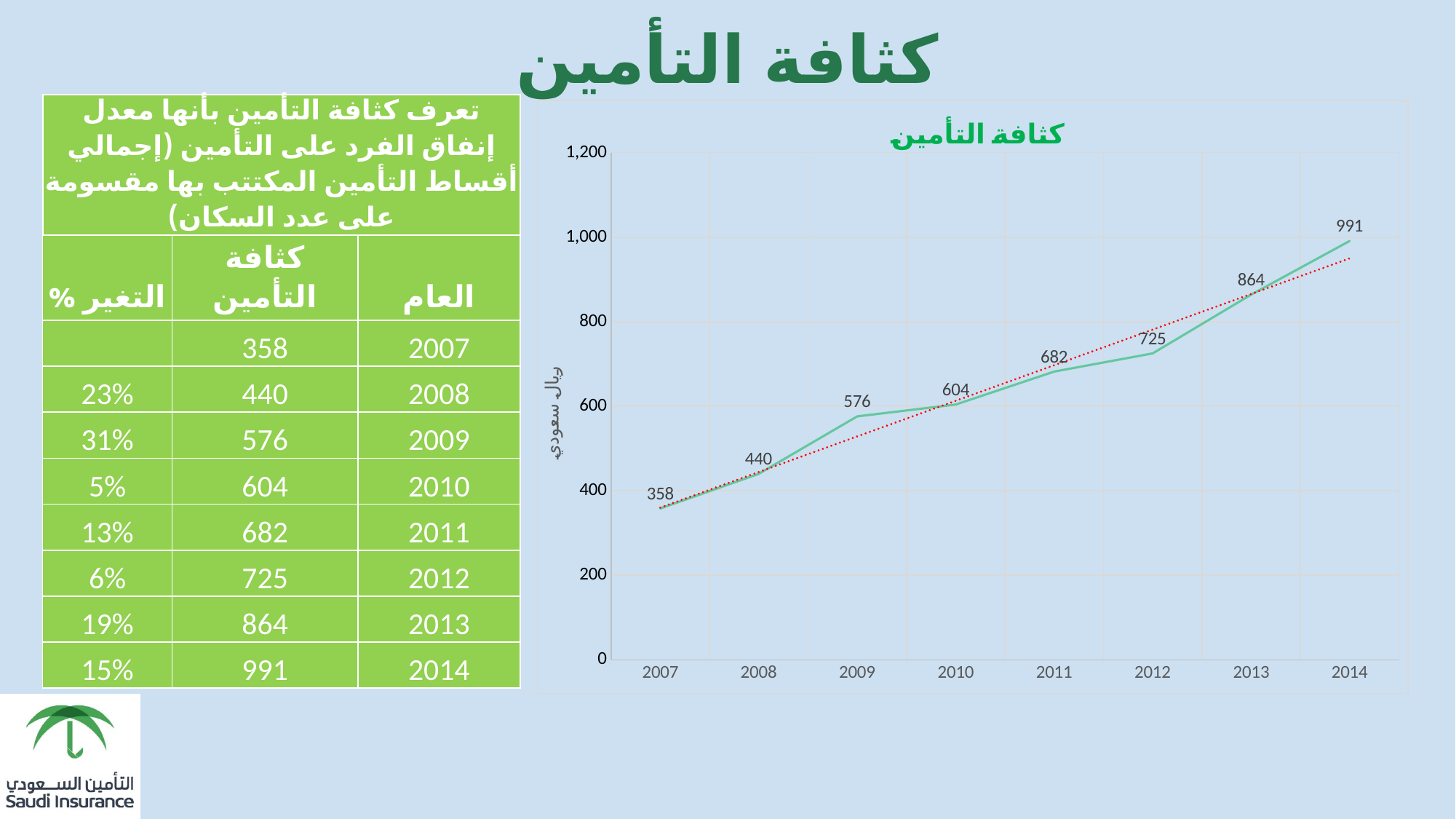
How many years are plotted on the x axis of the chart? 8 Is the value for 2014 greater or less than 1,000? less Which year has the lowest insurance density value in the chart? 2007 What is the title of the chart? كثافة التأمين What is the difference between the 2014 value and the 2007 value in the chart? 633 What is the difference between the 2012 value and the 2011 value in the chart? 43 Do the values in the chart rise or fall from 2007 to 2014? rise Which year has the highest insurance density value in the chart? 2014 What is the insurance density value for 2013 in the chart? 864 What is the insurance density value for 2010 in the chart? 604 Which is larger in the chart, the value for 2009 or the value for 2011? 2011 What kind of chart is shown on the slide? line chart